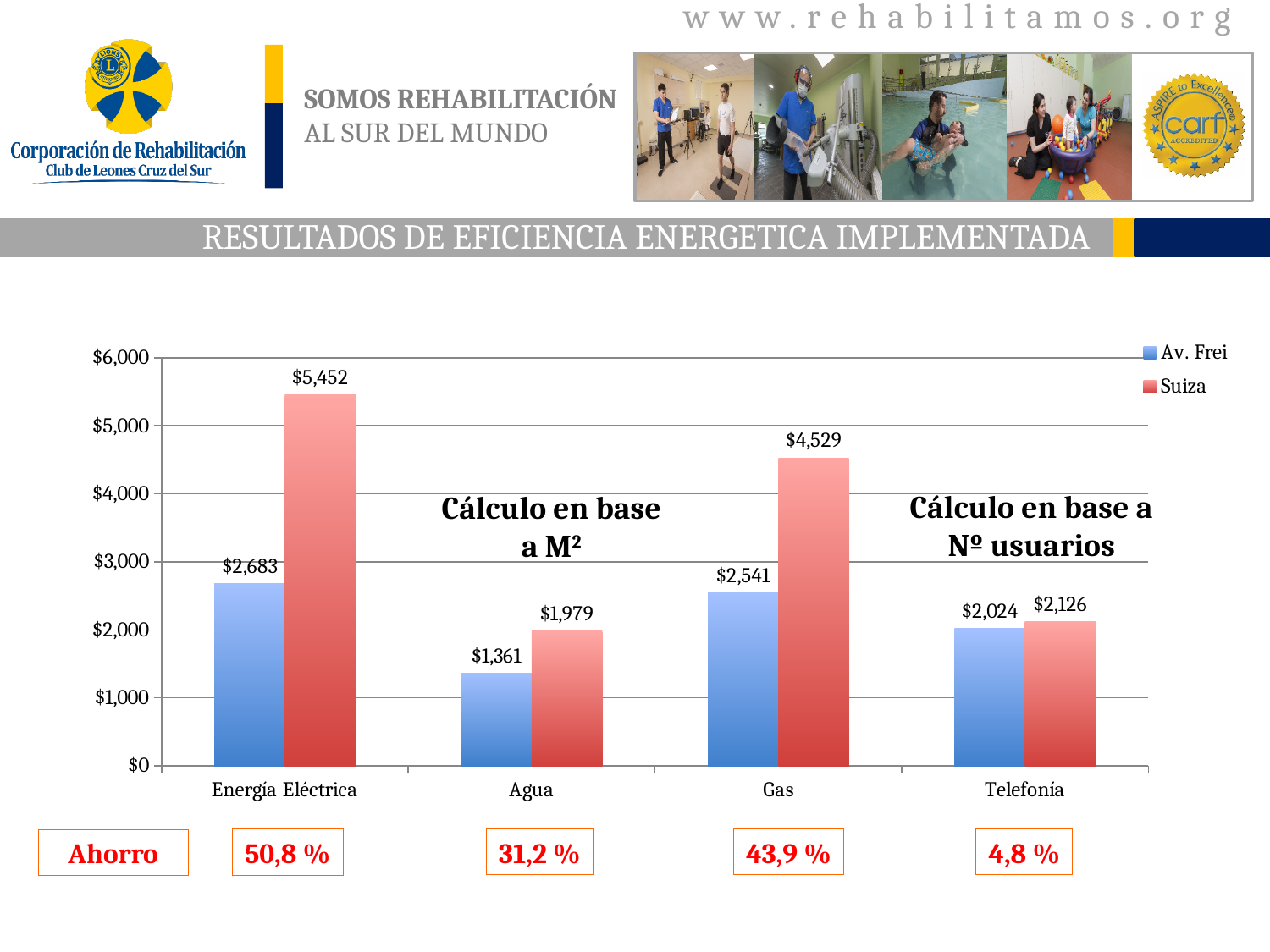
What is the value for Suiza in the Gas category? $4,529 What kind of chart is shown on the slide? bar chart What is the value for Av. Frei in the Energía Eléctrica category? $2,683 Which category has the highest Suiza value? Energía Eléctrica What is the value for Av. Frei in the Agua category? $1,361 How many categories are shown on the x axis? 4 Is the Suiza value for Agua greater or less than $2,000? less What is the value for Suiza in the Telefonía category? $2,126 Which category has the lowest Av. Frei value? Agua How many series does the legend list? 2 Which is larger for Gas: the Av. Frei value or the Suiza value? Suiza What is the difference between the Suiza and Av. Frei values for Energía Eléctrica? $2,769